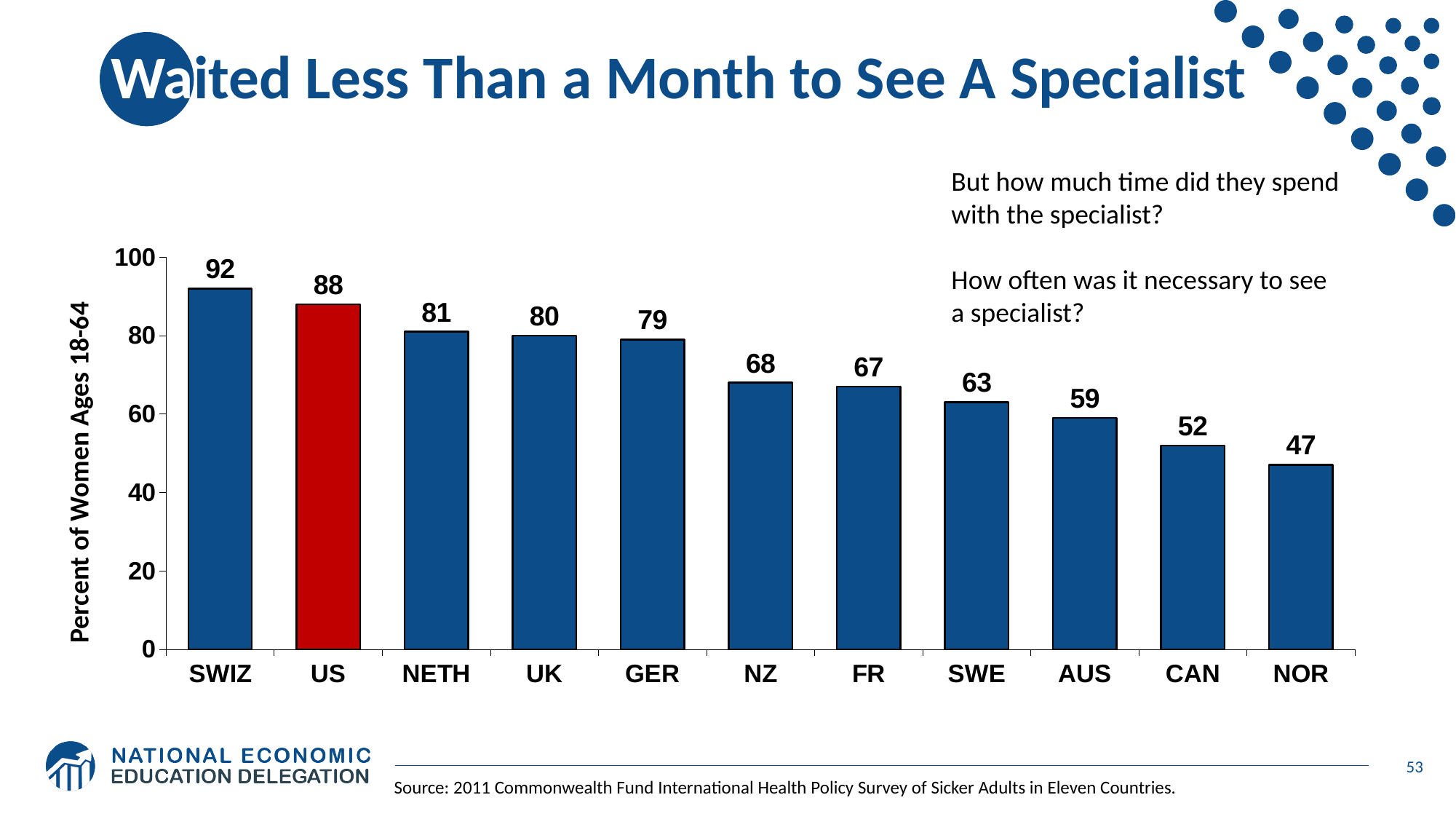
Which country has the highest value? SWIZ What is the difference between the values for NETH and CAN? 29 What is the value for GER? 79 What is the difference between the values for SWIZ and the US? 4 Which country has the lowest value? NOR What kind of chart is shown on the slide? bar chart How many countries are shown on the chart? 11 What is the value for the US? 88 Which has a larger value, NZ or SWE? NZ Which country's bar is coloured red? US What is the value for NOR? 47 Is the value for AUS greater or less than 60? less